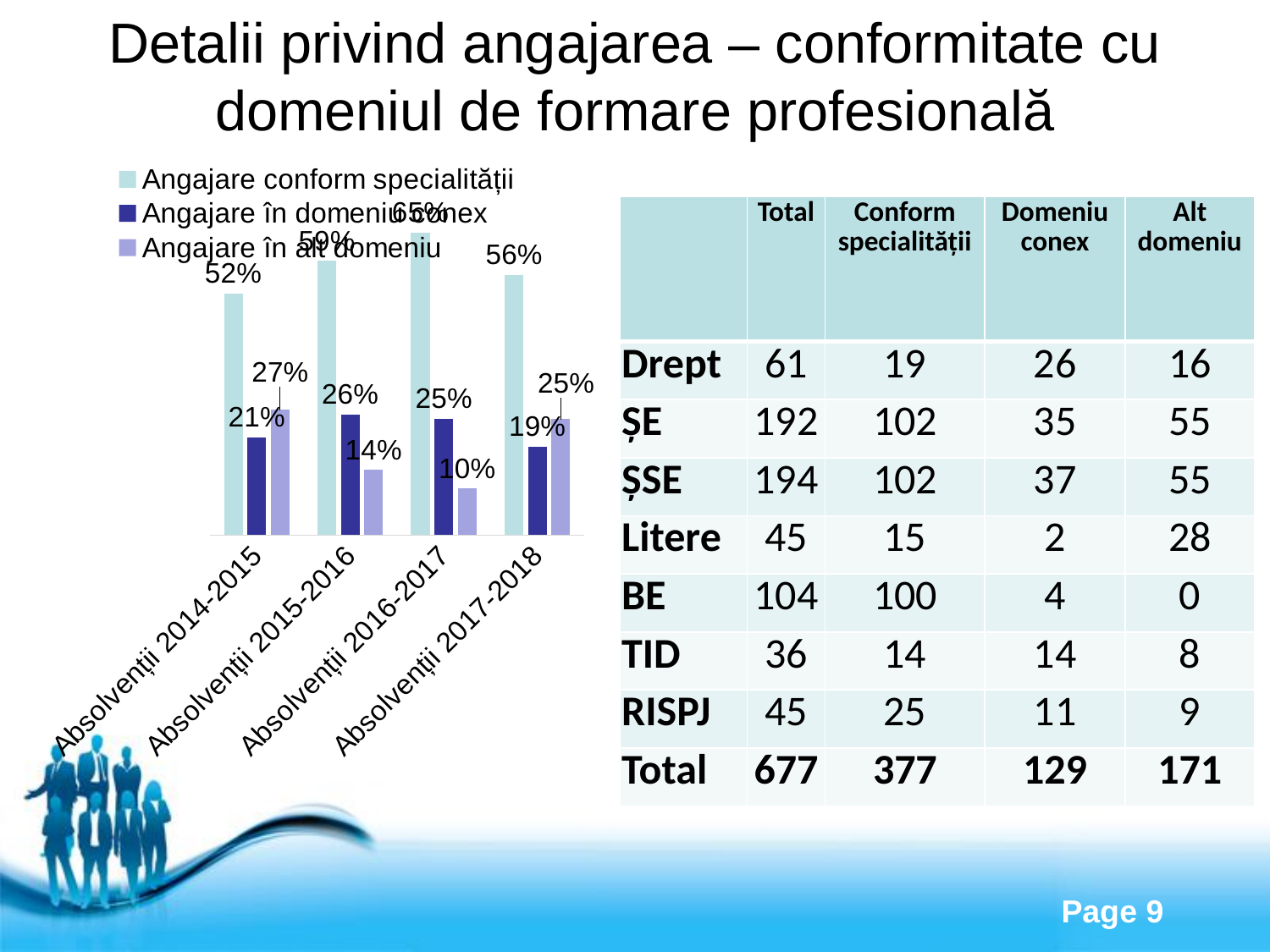
What is the value for 'Angajare în domeniu conex' for Absolvenții 2015-2016? 26% Which category has the lowest value for 'Angajare în alt domeniu'? Absolvenții 2016-2017 For Absolvenții 2014-2015, how much higher is 'Angajare în alt domeniu' than 'Angajare în domeniu conex'? 6 percentage points What kind of chart is shown on the slide? Bar chart What is the value for 'Angajare în alt domeniu' for Absolvenții 2016-2017? 10% Which category has the highest value for 'Angajare conform specialității'? Absolvenții 2016-2017 How many series does the chart legend list? 3 What is the value for 'Angajare în alt domeniu' for Absolvenții 2014-2015? 27% How many categories are shown on the x axis of the chart? 4 For Absolvenții 2017-2018, which is larger: 'Angajare în domeniu conex' or 'Angajare în alt domeniu'? Angajare în alt domeniu What is the value for 'Angajare conform specialității' for Absolvenții 2014-2015? 52% What is the value for 'Angajare conform specialității' for Absolvenții 2017-2018? 56%